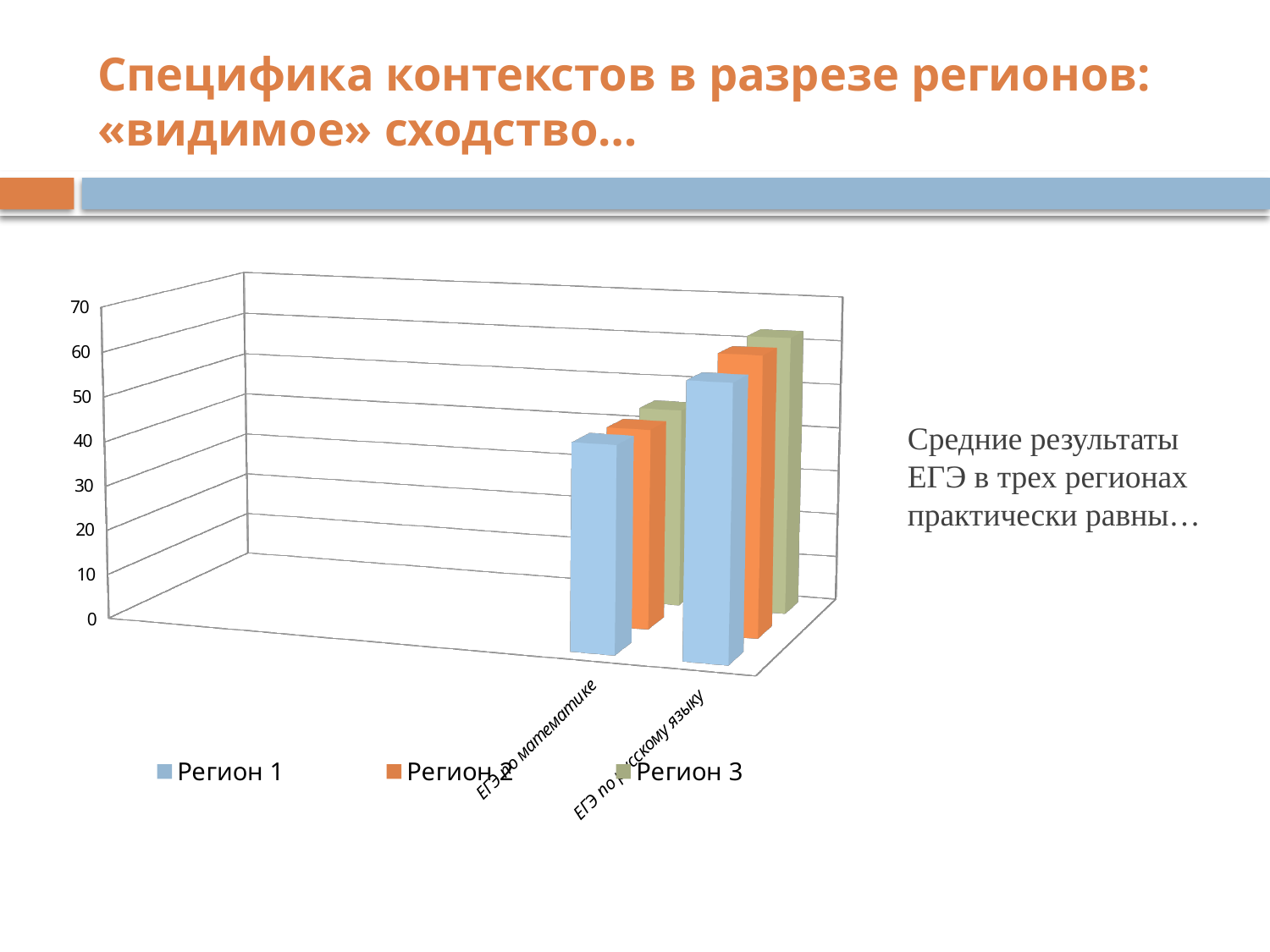
For Регион 3, which category has the larger value: ЕГЭ по математике or ЕГЭ по русскому языку? ЕГЭ по русскому языку For Регион 1, which category has the larger value: ЕГЭ по математике or ЕГЭ по русскому языку? ЕГЭ по русскому языку Is the value for Регион 2 in ЕГЭ по математике greater or less than 10? greater Is the value for Регион 1 in ЕГЭ по математике greater or less than 60? less Do the values for Регион 2 rise or fall from ЕГЭ по математике to ЕГЭ по русскому языку? rise What is the highest value shown on the vertical axis of the chart? 70 How many series does the legend list? 3 How many categories are shown on the x axis of the chart? 2 Which series are listed in the chart legend? Регион 1, Регион 2, Регион 3 What kind of chart is shown on the slide? bar chart Is the value for Регион 3 in ЕГЭ по русскому языку greater or less than 30? greater What colour are the bars for Регион 1? blue